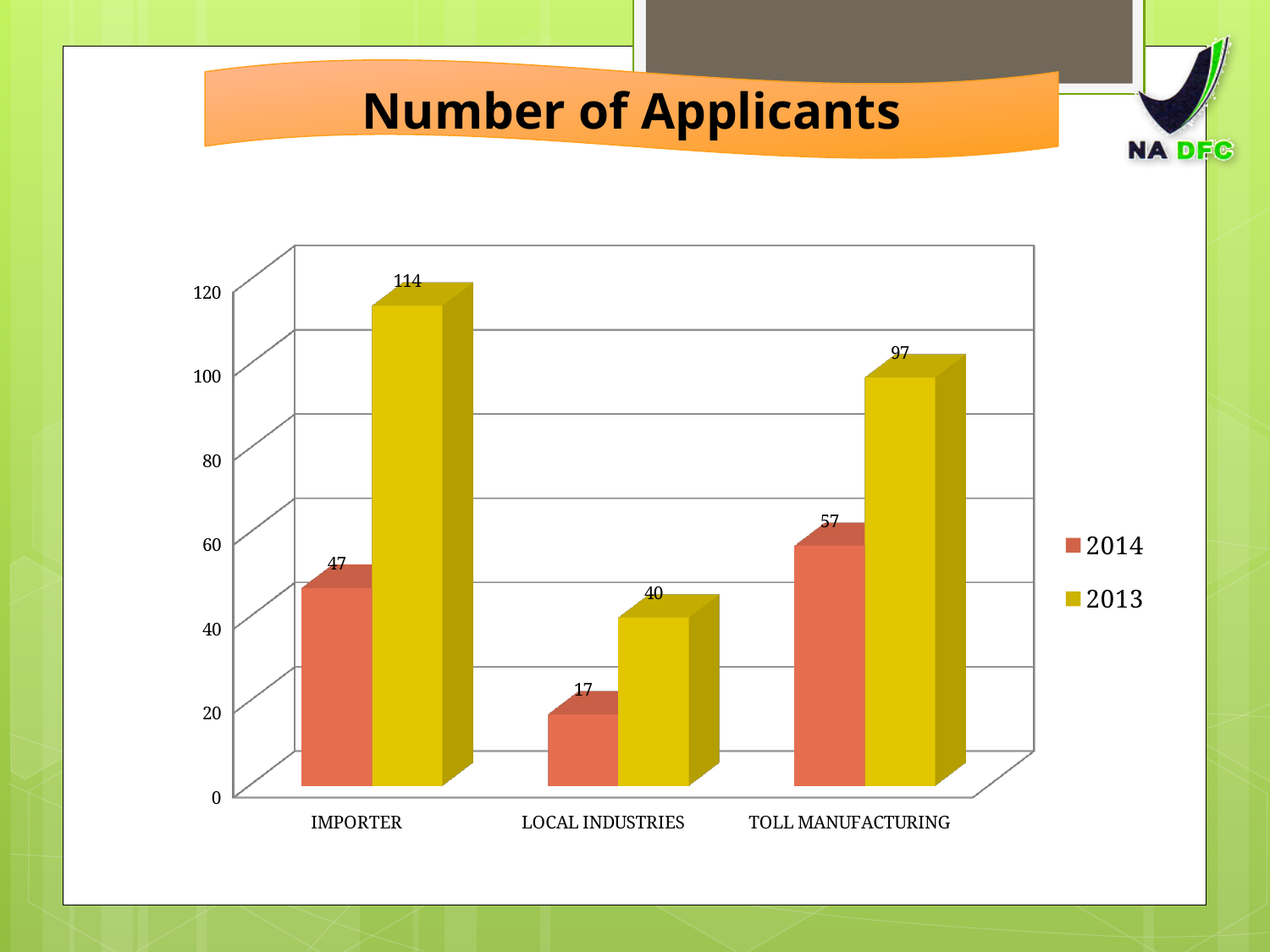
How many categories are shown on the x axis? 3 What is the number of applicants for TOLL MANUFACTURING in 2013? 97 Which category has the highest number of applicants in 2014? TOLL MANUFACTURING What is the number of applicants for LOCAL INDUSTRIES in 2014? 17 How many series does the legend list? 2 What is the number of applicants for IMPORTER in 2013? 114 Which category has the lowest number of applicants in 2013? LOCAL INDUSTRIES What kind of chart is shown on the slide? bar chart What is the difference between the 2013 and 2014 values for IMPORTER? 67 Is the 2013 value for LOCAL INDUSTRIES greater or less than 60? less Which is larger: the 2014 value for TOLL MANUFACTURING or the 2014 value for IMPORTER? TOLL MANUFACTURING What is the title of the chart? Number of Applicants